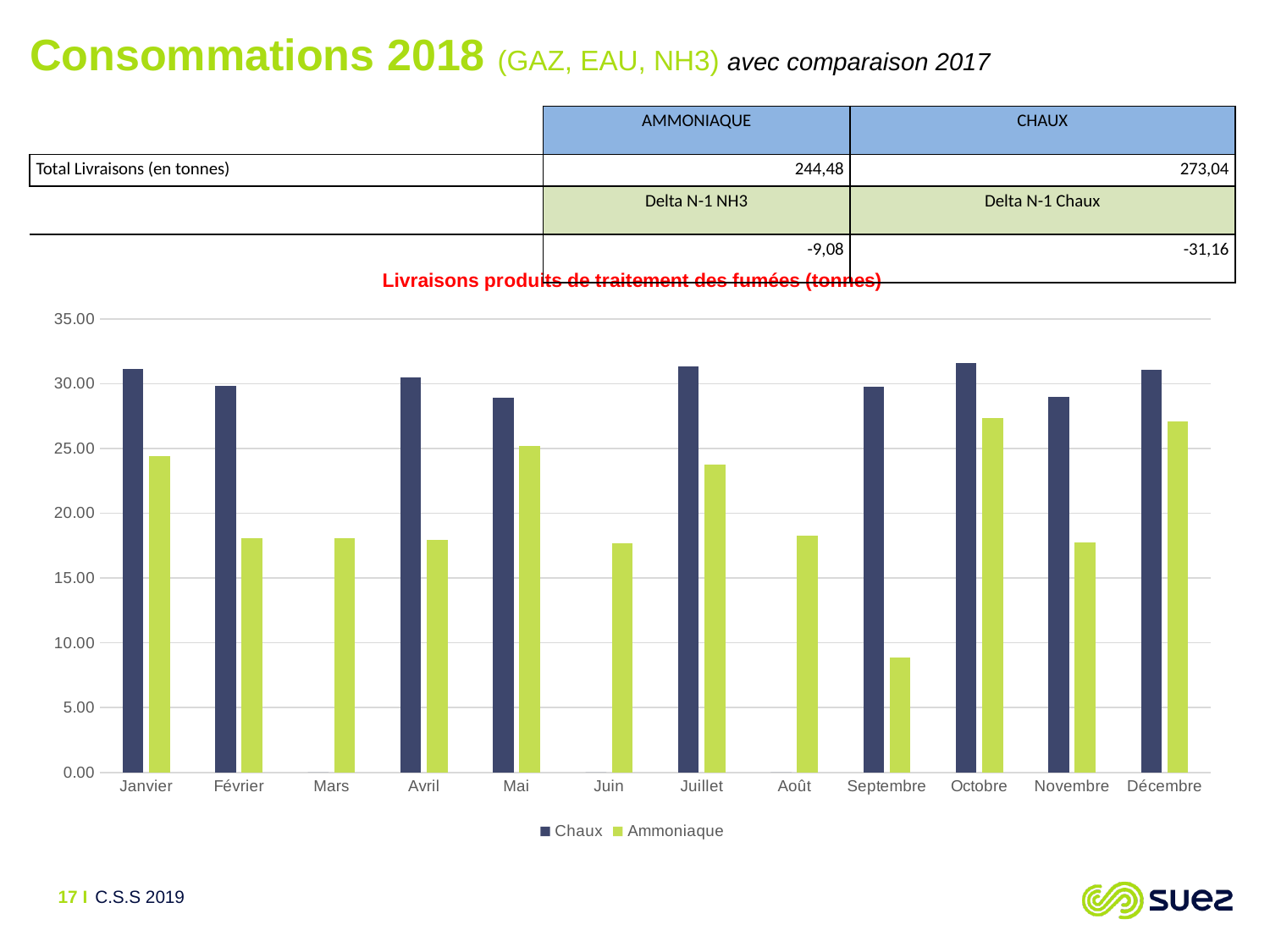
Is the Chaux value for Janvier greater or less than 30? greater Is the Chaux value for Mai greater or less than 30? less How many series does the chart legend list? 2 What kind of chart is shown on the slide? bar chart In how many months is there no Chaux bar shown? 3 In Janvier, which series has the larger value, Chaux or Ammoniaque? Chaux Which is larger, the Ammoniaque value for Mai or the Ammoniaque value for Février? Mai Is the Ammoniaque value for Septembre greater or less than 10? less What is the title of the chart? Livraisons produits de traitement des fumées (tonnes) How many months are shown on the x axis of the chart? 12 Which month has the lowest Ammoniaque value? Septembre